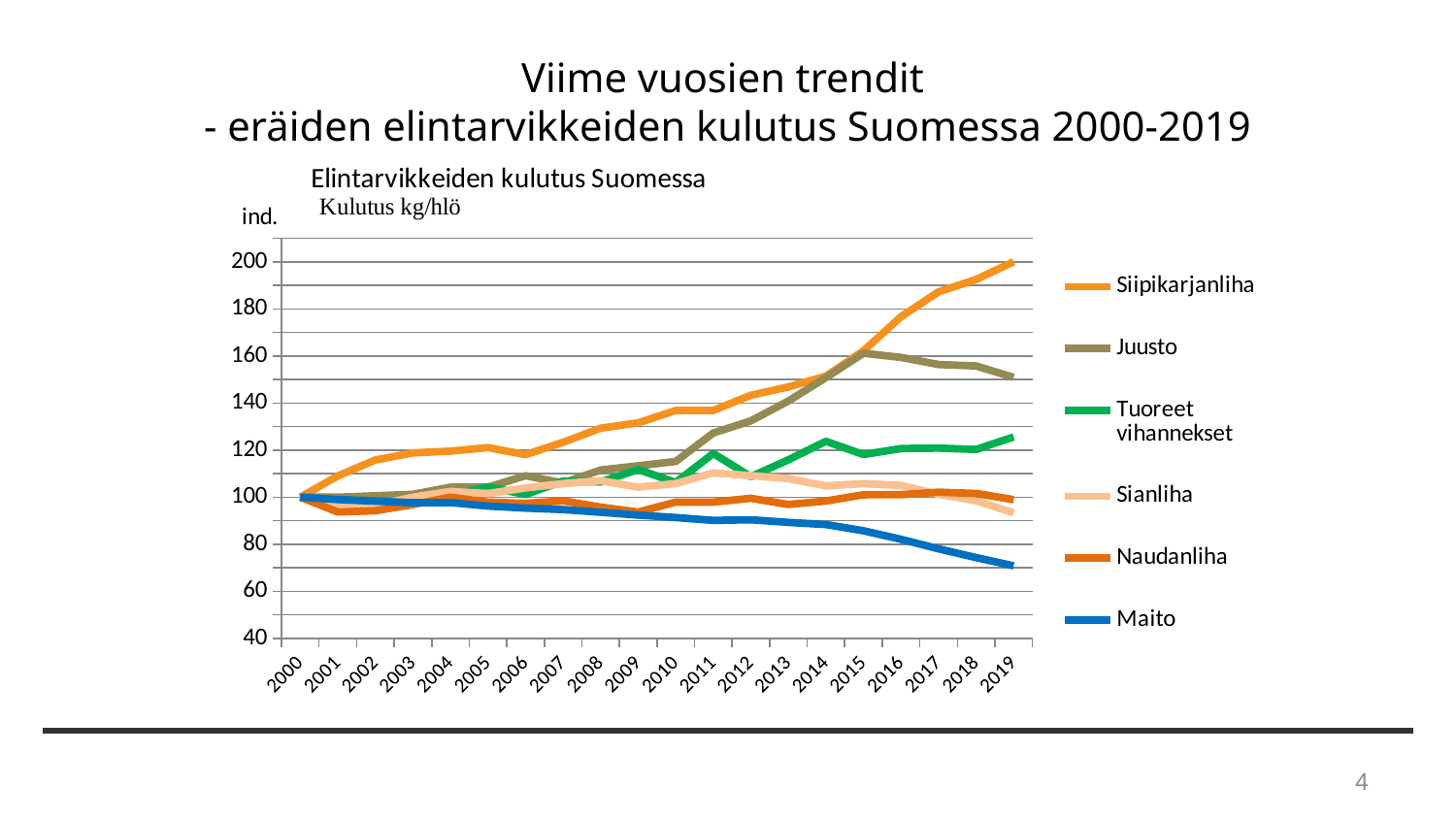
Does the value for Maito rise or fall from 2000 to 2019? fall Is the value for Maito in 2019 greater or less than 80? less In 2019, which is larger: Juusto or Tuoreet vihannekset? Juusto Which series has the highest value in 2019? Siipikarjanliha What is the title of the chart? Elintarvikkeiden kulutus Suomessa How many years are shown on the x axis? 20 Is the value for Siipikarjanliha in 2019 greater or less than 180? greater Does the value for Siipikarjanliha rise or fall from 2000 to 2019? rise Is the value for Juusto in 2015 greater or less than 140? greater What kind of chart is shown on the slide? line chart How many series does the legend list? 6 Which series has the lowest value in 2019? Maito